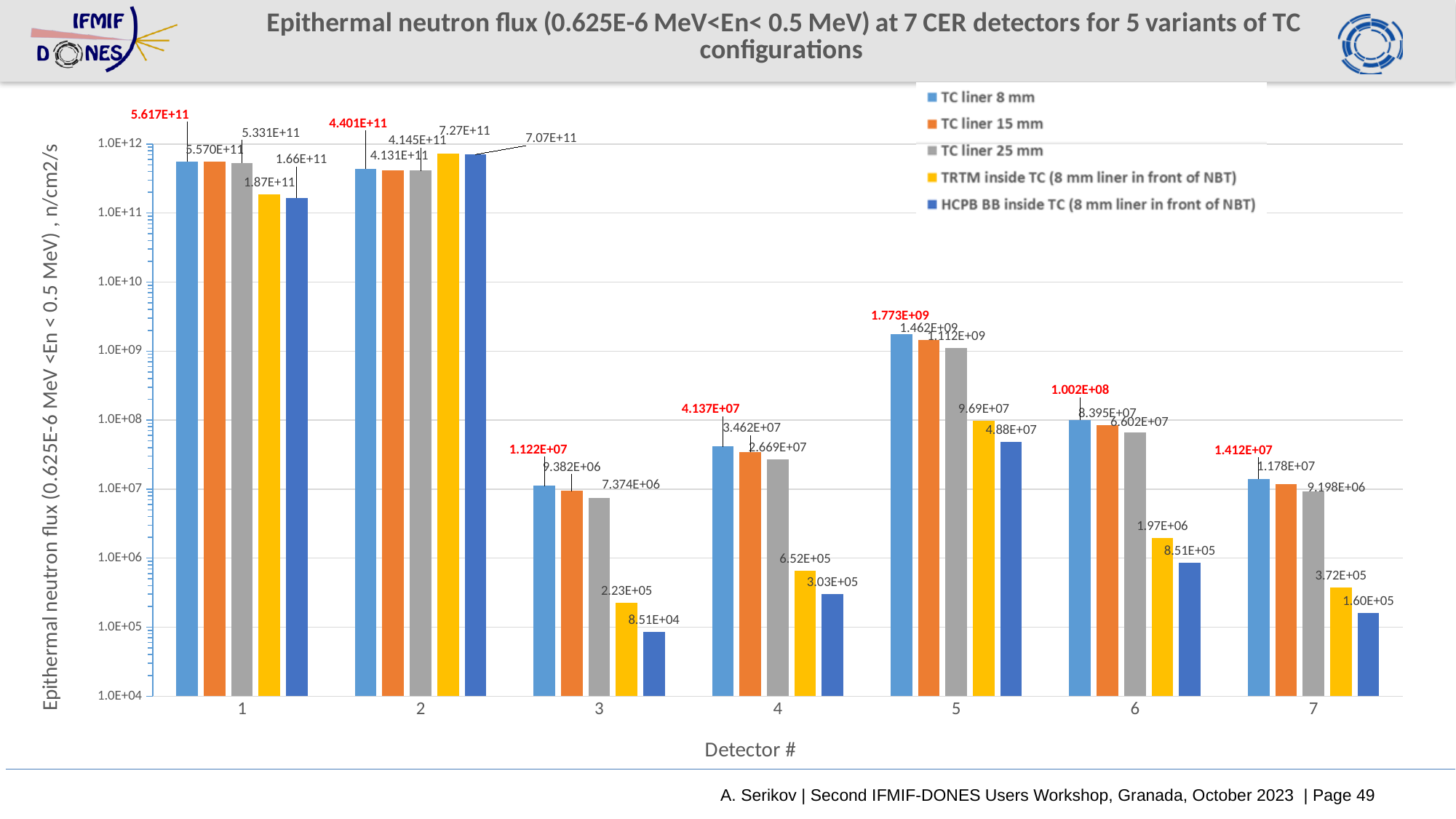
What is the epithermal neutron flux for TC liner 25 mm at detector 5? 1.112E+09 What is the epithermal neutron flux for TRTM inside TC at detector 2? 7.27E+11 What is the epithermal neutron flux for TC liner 8 mm at detector 1? 5.617E+11 How many series does the legend list? 5 What type of chart is shown on the slide? bar chart At which detector is the TC liner 8 mm flux lowest? 3 How many detectors are shown on the x axis? 7 What is the label of the x axis? Detector # At which detector is the TC liner 15 mm flux highest? 1 What is the epithermal neutron flux for HCPB BB inside TC at detector 3? 8.51E+04 Is the flux for HCPB BB inside TC at detector 5 greater or less than 1.0E+08? less At detector 2, which is larger: the flux for TC liner 8 mm or for TRTM inside TC? TRTM inside TC